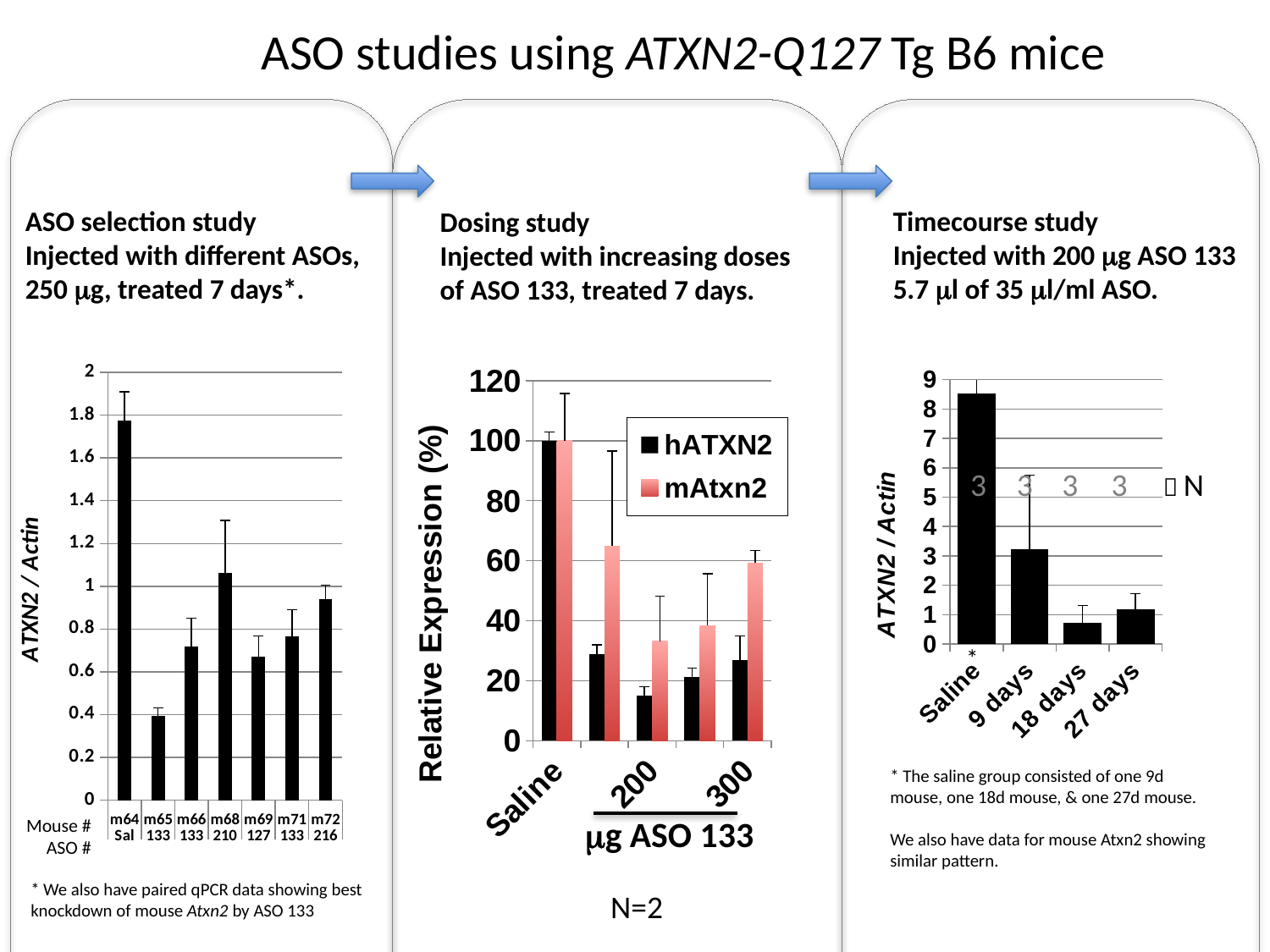
In the Dosing study chart in the middle, is the hATXN2 value at 200 µg ASO 133 greater or less than 40? less In the ASO selection study chart on the left, which mouse has the highest ATXN2 / Actin value? m64 (Sal) In the Timecourse study chart on the right, which group has the lowest ATXN2 / Actin value? 18 days In the ASO selection study chart on the left, is the value for m64 greater or less than 1.6? greater In the ASO selection study chart on the left, is the value for m65 greater or less than 0.6? less In the ASO selection study chart on the left, which mouse has the lowest ATXN2 / Actin value? m65 (ASO 133) In the Dosing study chart in the middle, at 300 µg ASO 133, which series has the larger value, hATXN2 or mAtxn2? mAtxn2 What are the two legend entries in the Dosing study chart in the middle? hATXN2 and mAtxn2 In the Timecourse study chart on the right, which group has the highest ATXN2 / Actin value? Saline What kind of chart is the ASO selection study chart on the left? bar chart How many mice (bars) are plotted in the ASO selection study chart on the left? 7 How many series does the legend of the Dosing study chart in the middle list? 2